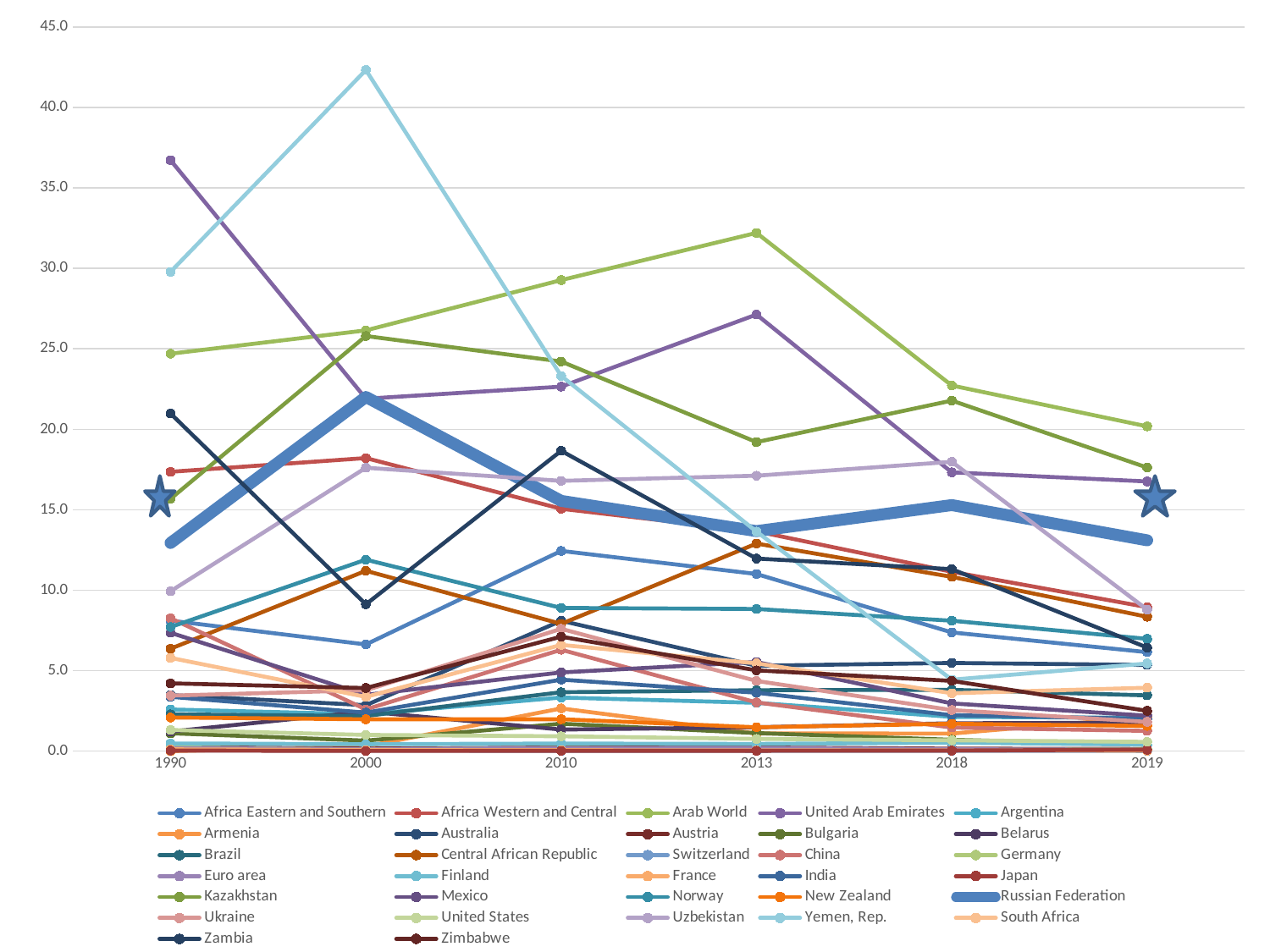
Which is larger in 2013, the value for Arab World or the value for Kazakhstan? Arab World Which series has the highest value in 2019? Arab World Is the value for Yemen, Rep. in 2000 greater or less than 40? greater What kind of chart is shown on the slide? line chart Does the value for Yemen, Rep. rise or fall from 2000 to 2018? fall Which series is drawn with the thickest line on the chart? Russian Federation Is the value for Russian Federation in 2019 greater or less than 15? less Which series has the highest value in 1990? United Arab Emirates Is the value for Arab World in 2013 greater or less than 30? greater How many years are shown along the x axis? 6 How many series does the legend list? 32 Which series has the highest value in 2000? Yemen, Rep.